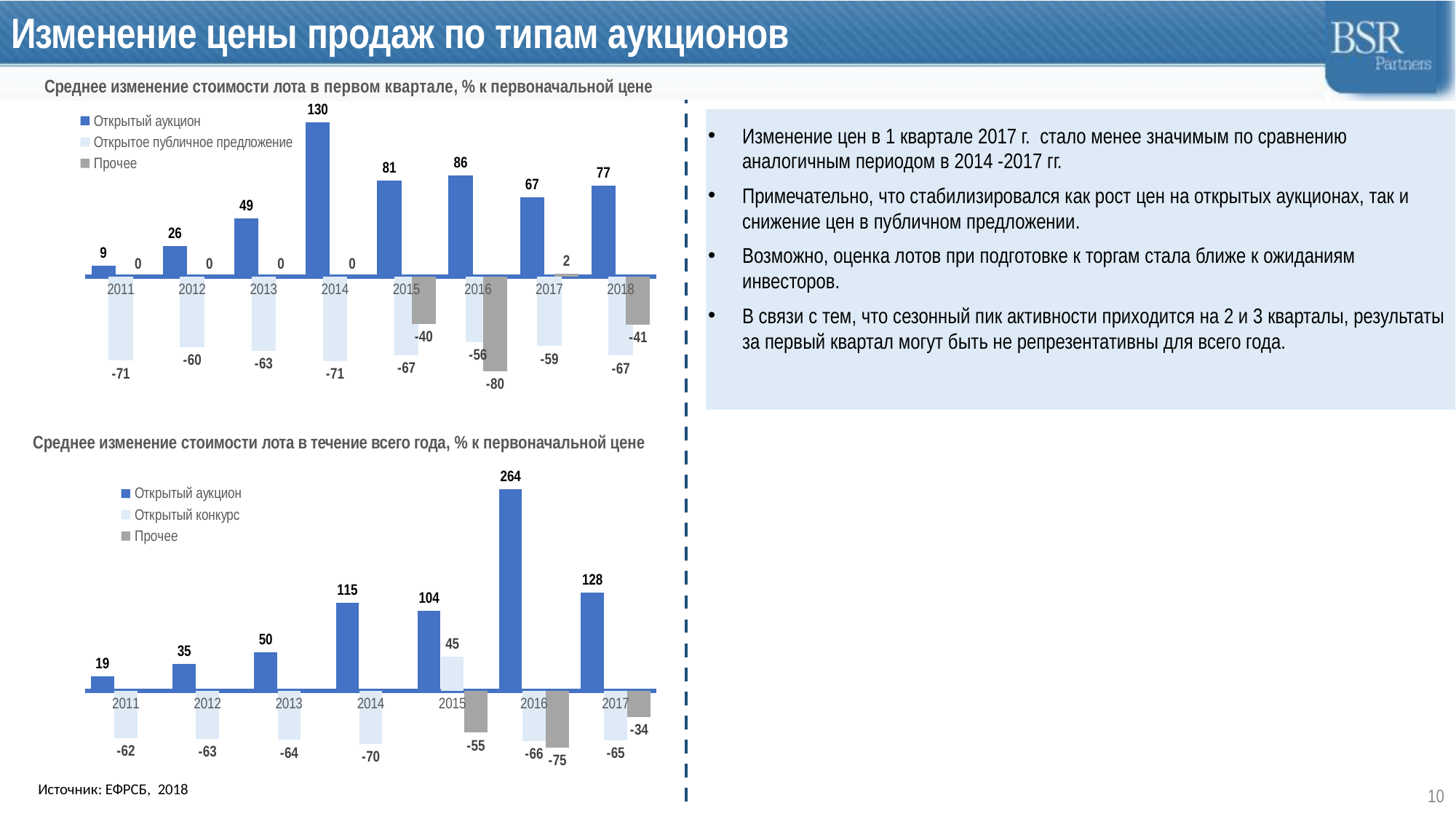
In the bottom chart (whole year), what is the value for Открытый аукцион in 2016? 264 In the top chart (first quarter), how many years are shown on the x axis? 8 In the bottom chart (whole year), which is larger for Открытый аукцион: 2014 or 2015? 2014 In the top chart (first quarter), how many series does the legend list? 3 In the bottom chart (whole year), what is the difference between the Открытый аукцион values for 2017 and 2011? 109 In the bottom chart (whole year), what is the value for Прочее in 2017? -34 In the top chart (first quarter), what is the difference between the Открытый аукцион values for 2016 and 2017? 19 In the top chart (first quarter), what is the value for Открытый аукцион in 2014? 130 In the top chart (first quarter), which year has the highest value for Открытый аукцион? 2014 In the top chart (first quarter), which year has the lowest value for Прочее? 2016 In the top chart (first quarter), what is the value for Открытое публичное предложение in 2016? -56 What type of chart is the bottom chart (whole year)? Bar chart